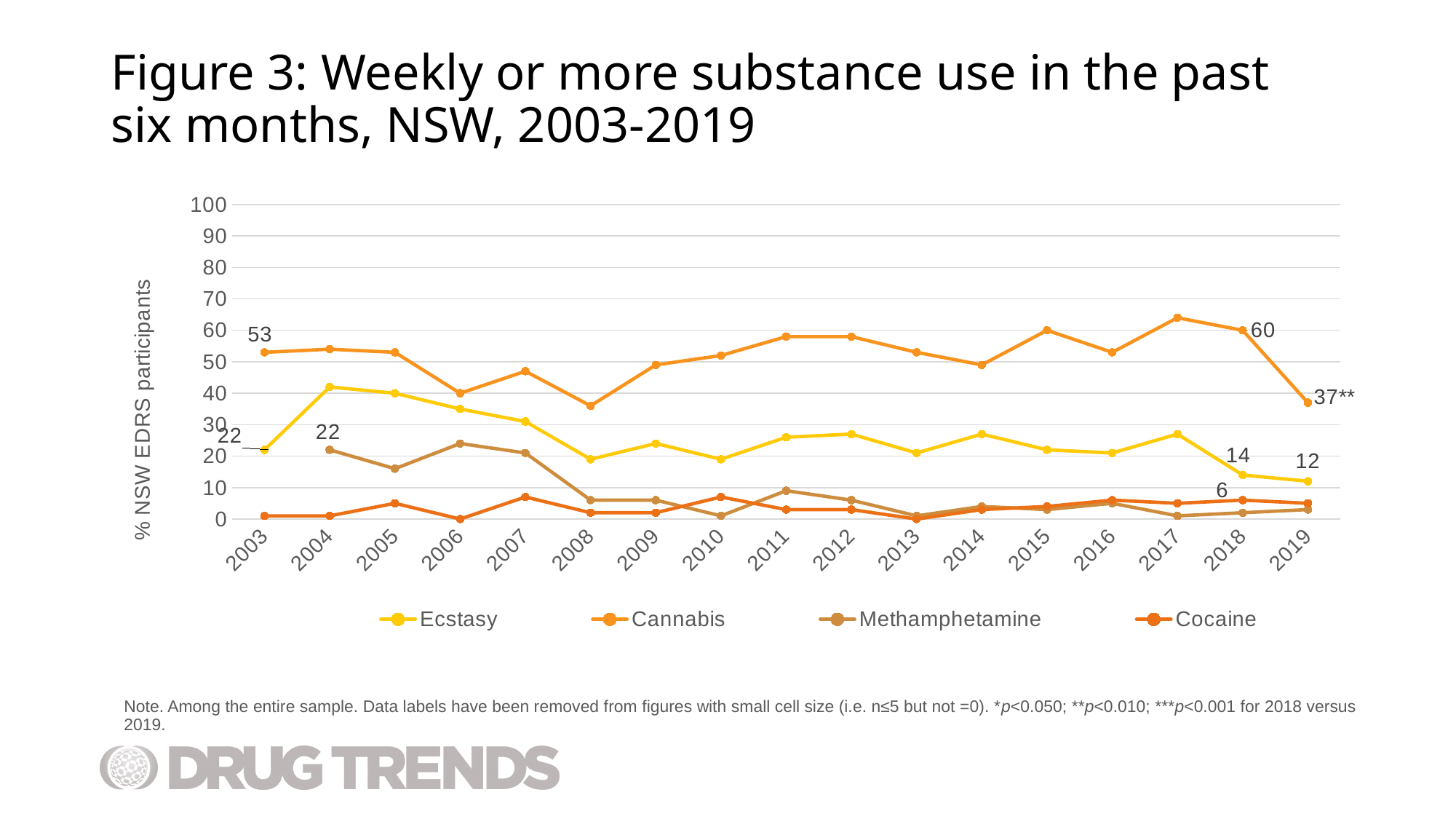
How many series does the legend list? 4 Which series has the highest value in 2019? Cannabis Is the value for Cannabis in 2017 greater or less than 50? greater What is the value for Ecstasy in 2019? 12 What is the difference between the Ecstasy values for 2018 and 2019? 2 What is the value for Cocaine in 2018? 6 How many years are plotted along the x axis? 17 What is the value for Methamphetamine in 2004? 22 What is the label on the y axis? % NSW EDRS participants What is the value for Cannabis in 2003? 53 What is the value for Cannabis in 2018? 60 What kind of chart is shown on the slide? line chart